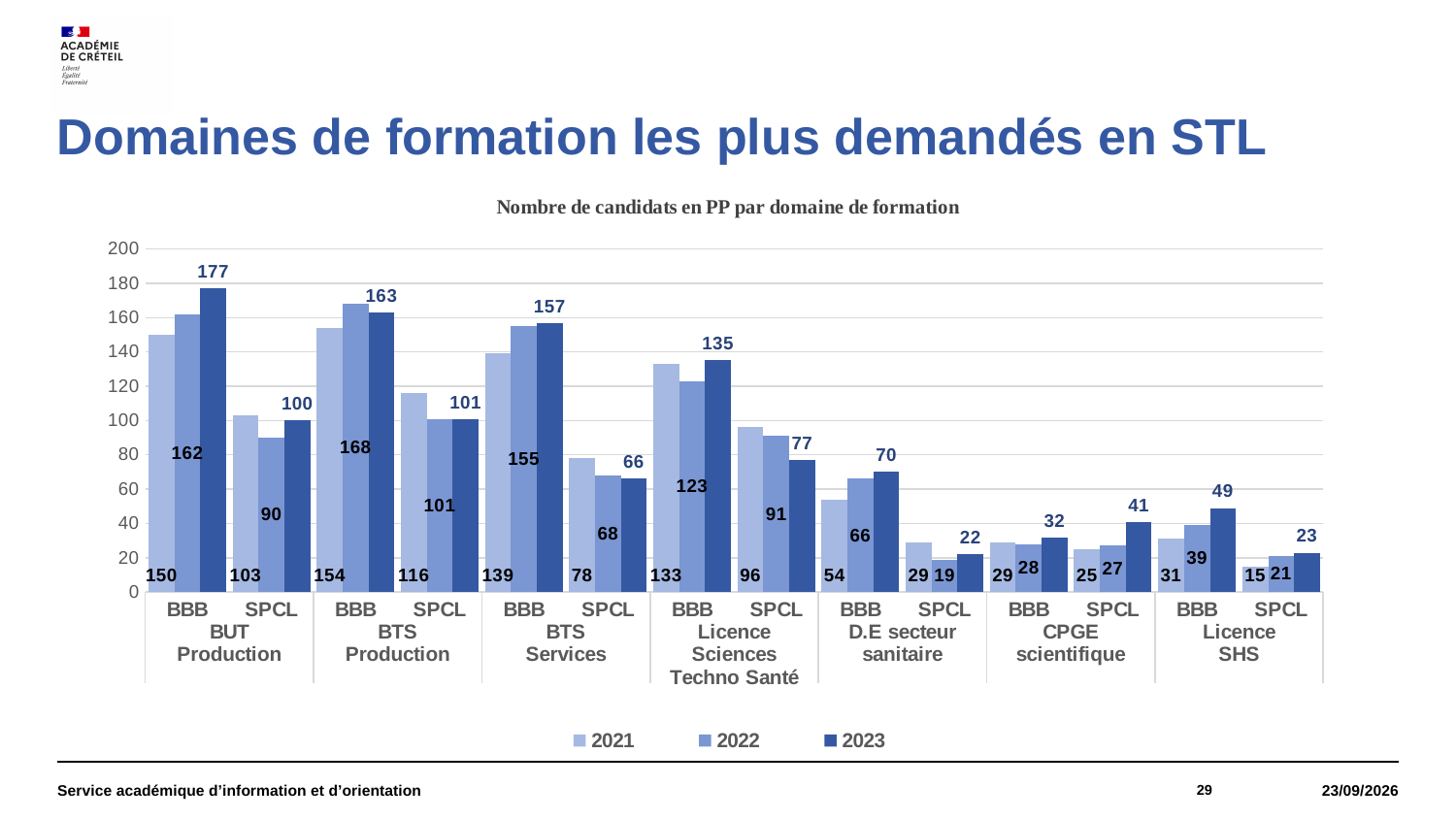
What is the title of the chart? Nombre de candidats en PP par domaine de formation Do the values for BBB in Licence SHS rise or fall from 2021 to 2023? rise Which is larger for BBB in BTS Production: the 2022 value or the 2023 value? 2022 What is the difference between the 2023 and 2021 values for BBB in BUT Production? 27 Which category has the highest 2023 value? BBB BUT Production What is the number of candidates for BBB in BUT Production in 2023? 177 Is the 2022 value for BBB in BTS Services greater or less than 140? greater What is the number of candidates for SPCL in BTS Services in 2021? 78 What is the 2022 value for BBB in Licence Sciences Techno Santé? 123 What kind of chart is shown on the slide? bar chart Which category has the lowest 2021 value? SPCL Licence SHS How many series does the legend list? 3